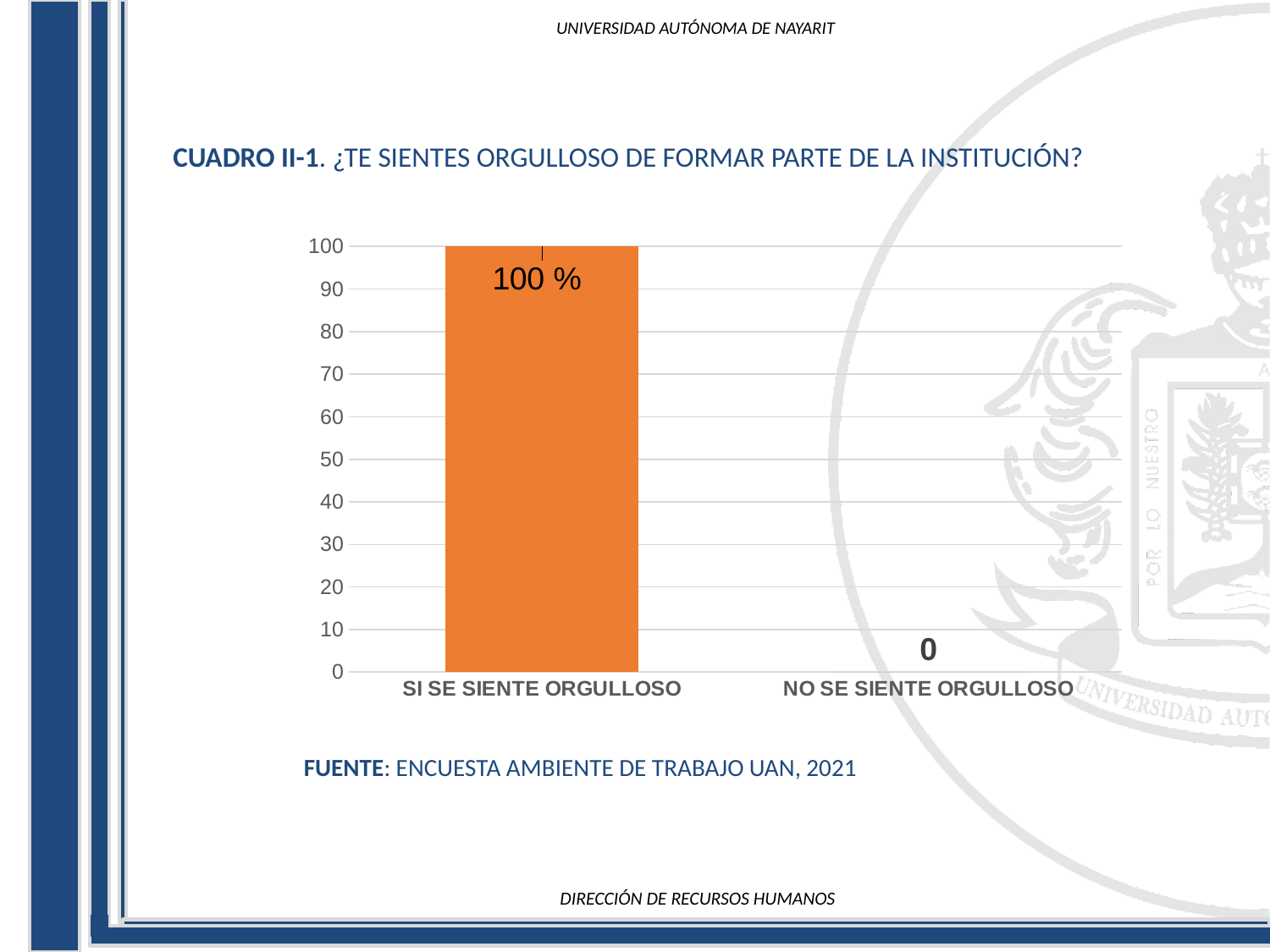
Which category has the lowest value? NO SE SIENTE ORGULLOSO What is the maximum value shown on the y axis? 100 What is the value for SI SE SIENTE ORGULLOSO? 100 % Do the values rise or fall from left to right along the x axis? fall How many categories are shown on the x axis? 2 What is the title of the chart (CUADRO II-1)? ¿TE SIENTES ORGULLOSO DE FORMAR PARTE DE LA INSTITUCIÓN? What is the difference between the values for SI SE SIENTE ORGULLOSO and NO SE SIENTE ORGULLOSO? 100 Is the value for SI SE SIENTE ORGULLOSO greater or less than 50? greater Which is larger, the value for SI SE SIENTE ORGULLOSO or NO SE SIENTE ORGULLOSO? SI SE SIENTE ORGULLOSO What kind of chart is shown on the slide? bar chart Which category has the highest value? SI SE SIENTE ORGULLOSO What is the value for NO SE SIENTE ORGULLOSO? 0